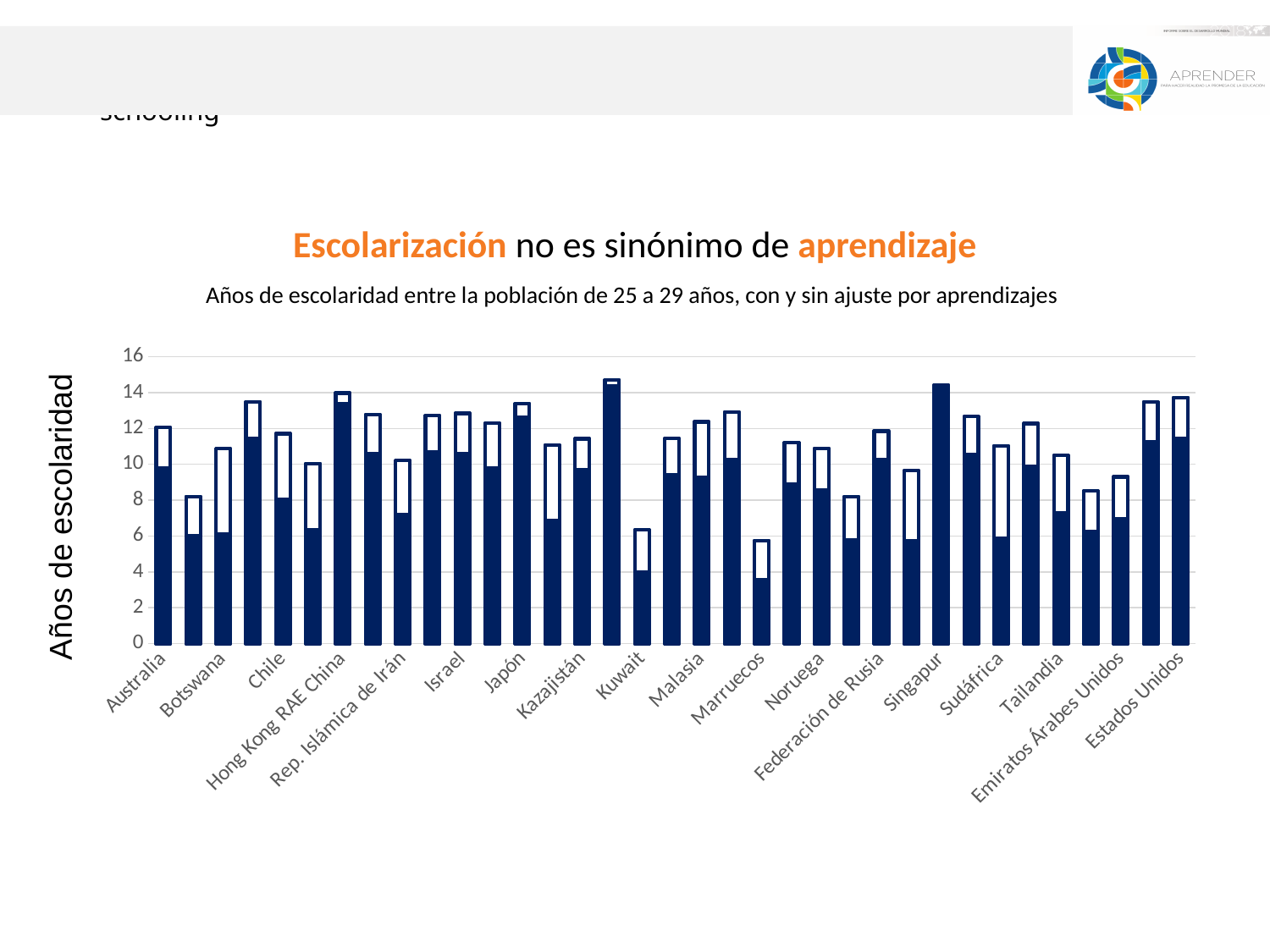
What is the title of the chart? Escolarización no es sinónimo de aprendizaje Is the dark blue (learning-adjusted) bar for Marruecos greater or less than 4? less Which has the taller dark blue (learning-adjusted) bar, Chile or Kuwait? Chile What is the label on the vertical axis of the chart? Años de escolaridad Which has the taller dark blue (learning-adjusted) bar, Singapur or Australia? Singapur Is the dark blue (learning-adjusted) bar for Singapur greater or less than 14? greater What kind of chart is shown on the slide? bar chart Is the outlined (unadjusted) bar for Estados Unidos greater or less than 12? greater Which has the taller outlined (unadjusted) bar, Hong Kong RAE China or Tailandia? Hong Kong RAE China